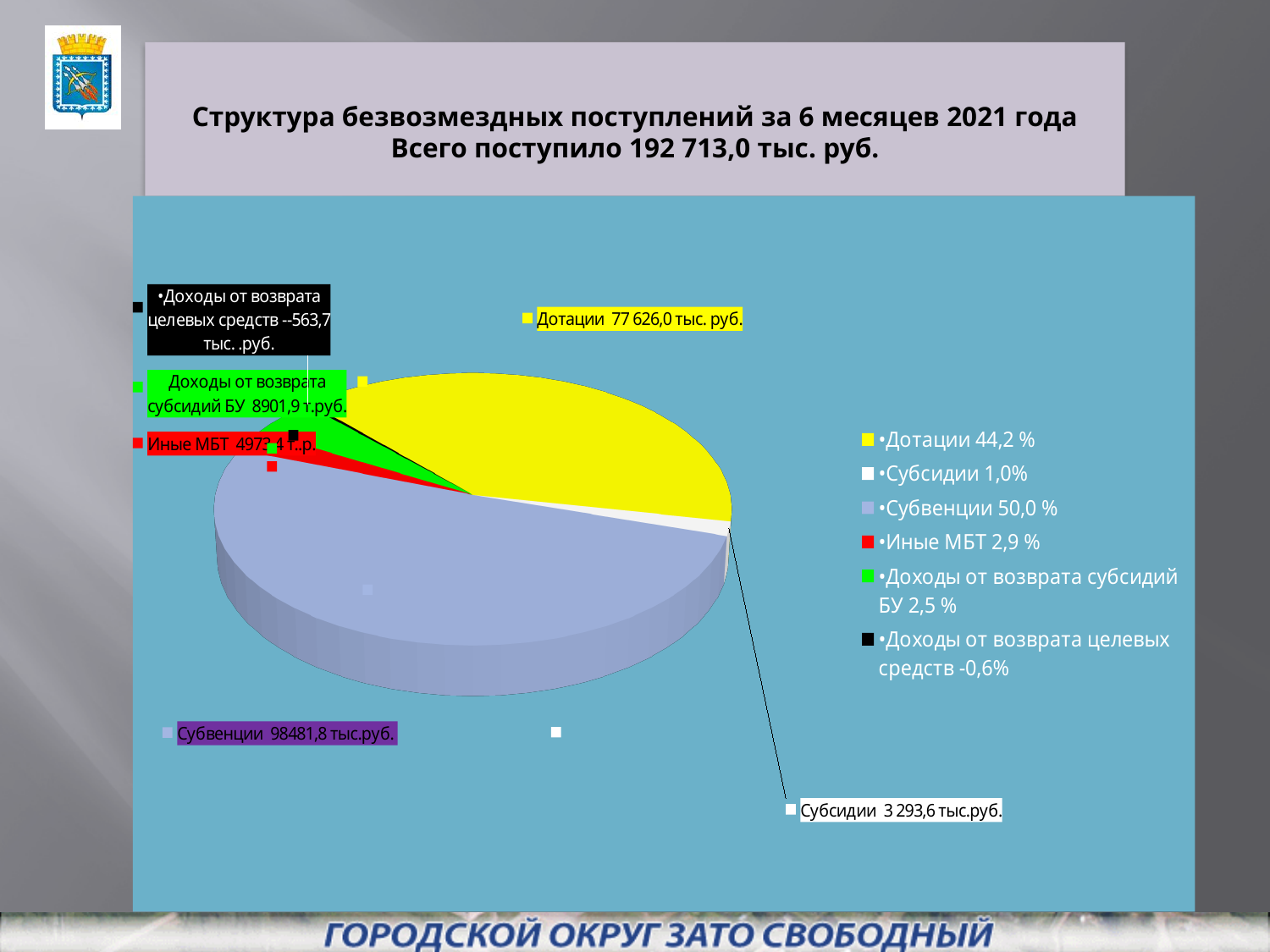
What is the value shown for Субвенции on the pie chart? 98481,8 тыс.руб. How many categories does the legend of the pie chart list? 6 Which category has the largest slice of the pie chart? Субвенции What is the total amount of receipts stated in the chart title? 192 713,0 тыс. руб. What share of the pie does Дотации represent according to the legend? 44,2 % What share of the pie does Субвенции represent according to the legend? 50,0 % What kind of chart is shown on the slide? Pie chart What is the value shown for Субсидии on the pie chart? 3 293,6 тыс.руб. Which is larger, Дотации or Субвенции? Субвенции What is the value shown for Дотации on the pie chart? 77 626,0 тыс. руб. What is the value shown for Доходы от возврата субсидий БУ on the pie chart? 8901,9 т.руб. What share of the pie does Иные МБТ represent according to the legend? 2,9 %